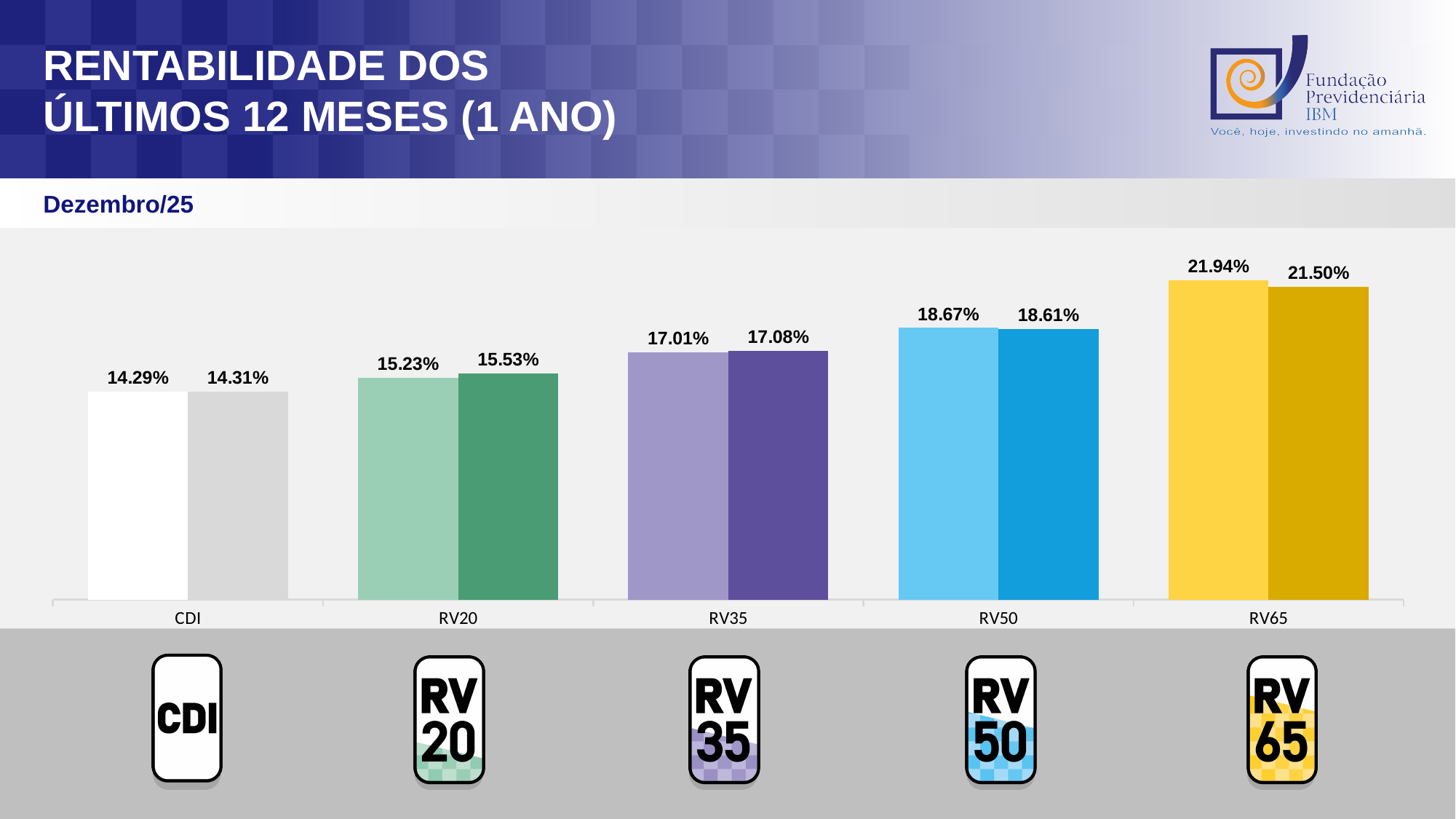
What kind of chart is shown on the slide? bar chart What is the value shown on the right (darker) bar for CDI? 14.31% Do the values rise or fall moving from CDI to RV65 along the x axis? rise Which category has the lowest values in the chart? CDI For RV65, which bar shows the larger value, the left (lighter) one or the right (darker) one? the left (lighter) one, 21.94% What is the difference between the left (lighter) bar of RV65 and the left (lighter) bar of CDI? 7.65 percentage points What is the difference between the two bars shown for RV20? 0.30 percentage points What is the value shown on the right (darker) bar for RV50? 18.61% What is the value shown on the left (lighter) bar for RV65? 21.94% What is the value shown on the left (lighter) bar for RV35? 17.01% Which category has the highest values in the chart? RV65 How many categories are shown on the x axis of the chart? 5